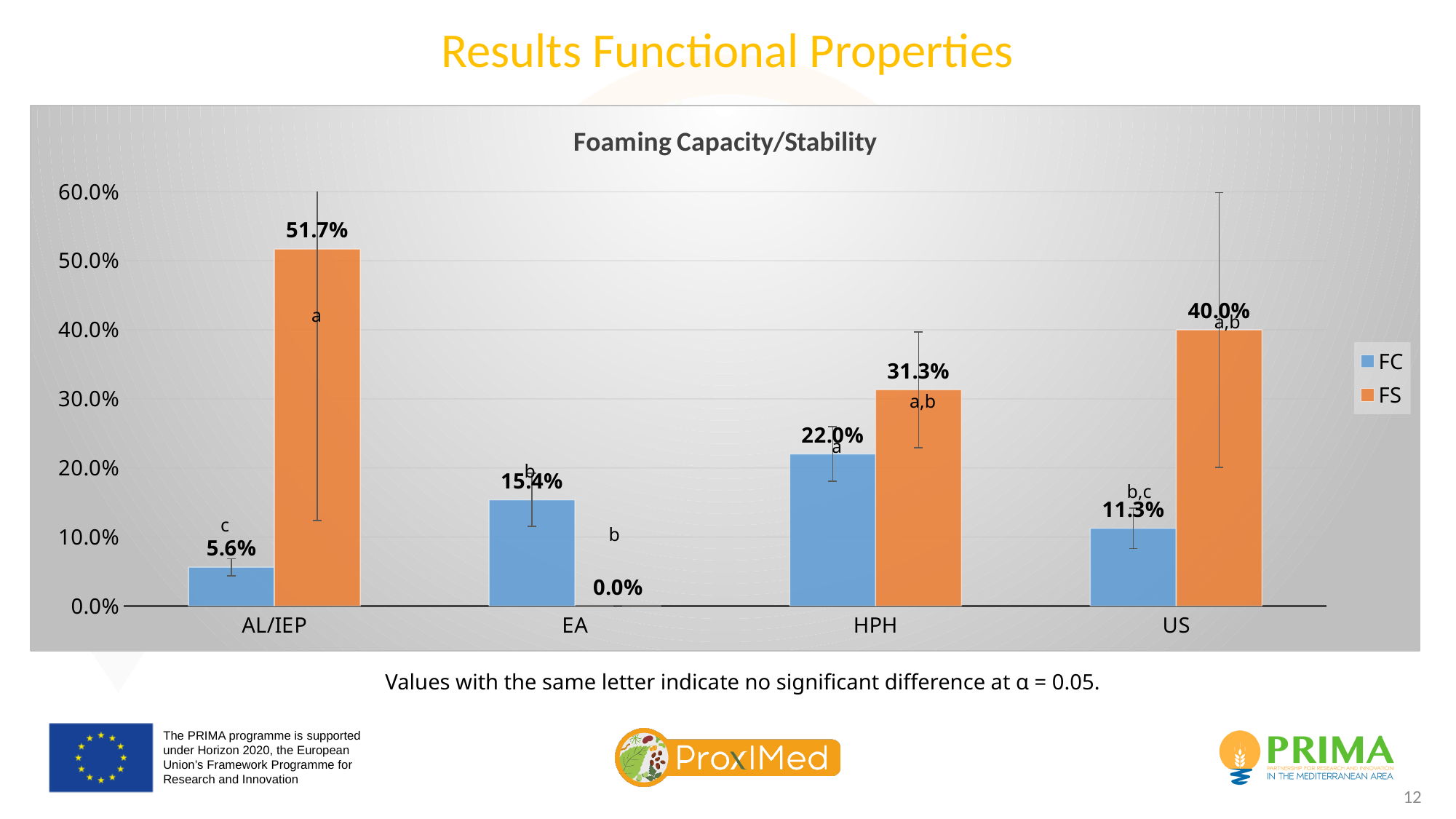
What is the FS value for AL/IEP? 51.7% What is the FS value for EA? 0.0% Is the FS value for US greater or less than 30.0%? greater What kind of chart is shown on the slide? Bar chart Which category has the highest FS value? AL/IEP What is the FC value for US? 11.3% What is the FC value for HPH? 22.0% Which category has the lowest FC value? AL/IEP How many series does the legend list? 2 Which is larger, the FC value for EA or the FC value for US? FC value for EA What is the difference between the FS and FC values for HPH? 9.3% How many categories are shown on the x axis? 4